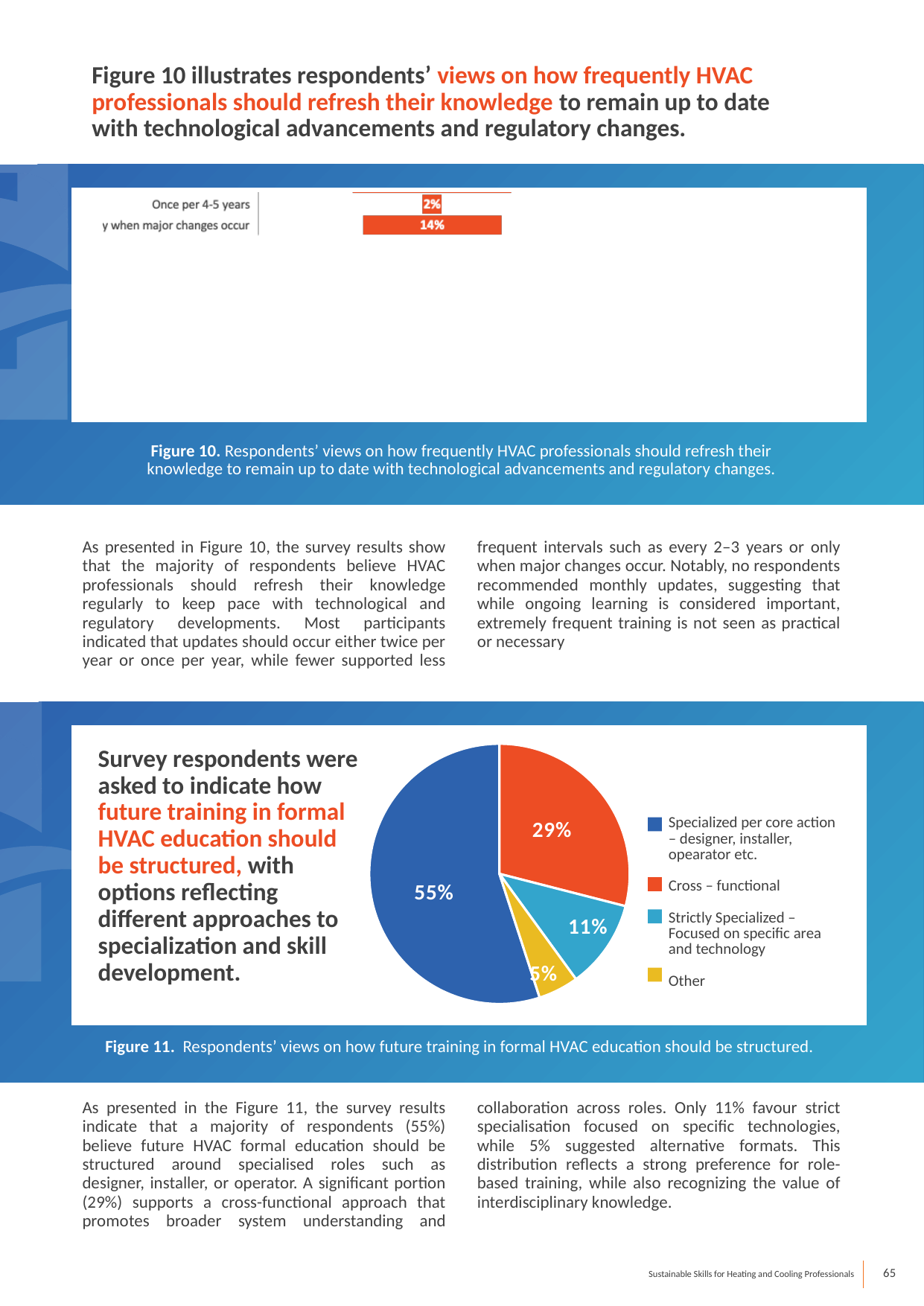
In Figure 11, what percentage of respondents chose 'Other'? 5% In Figure 11, which option has the largest share of the pie? Specialized per core action – designer, installer, operator etc. In Figure 10, which is larger: the value for 'Once per 4-5 years' or the value for the bar labelled 'when major changes occur'? when major changes occur In Figure 10, what value is shown for 'Once per 4-5 years'? 2% In Figure 11, what percentage of respondents chose 'Cross – functional'? 29% In Figure 11, what is the difference in percentage points between 'Specialized per core action' and 'Cross – functional'? 26 In Figure 11, what percentage of respondents chose 'Strictly Specialized – Focused on specific area and technology'? 11% How many entries does the legend of Figure 11 list? 4 In Figure 11, what share of respondents chose 'Specialized per core action – designer, installer, operator etc.'? 55% What kind of chart is Figure 11? Pie chart In Figure 11, which is larger: the share for 'Cross – functional' or the share for 'Strictly Specialized'? Cross – functional In Figure 11, which option has the smallest share of the pie? Other